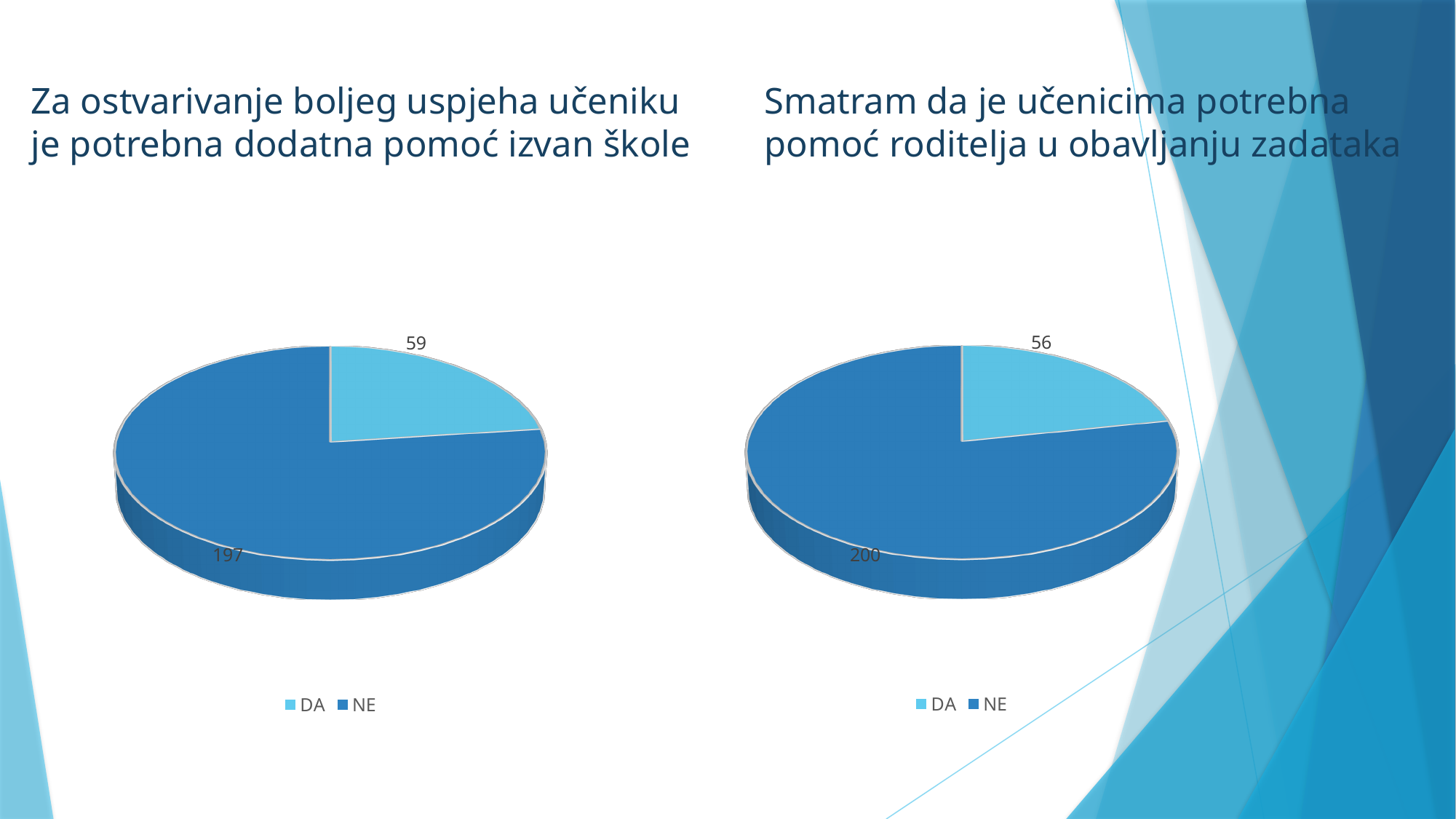
In the left chart, what is the difference between the NE and DA values? 138 What kind of chart is the left chart? Pie chart How many slices does the right chart have? 2 In the right chart, what is the difference between the NE and DA values? 144 What entries does the legend of the left chart list? DA, NE In the right chart, which category has the smallest slice? DA In the left chart, which category has the largest slice? NE In the left chart (Za ostvarivanje boljeg uspjeha učeniku je potrebna dodatna pomoć izvan škole), what is the value for NE? 197 Which is larger: the DA value in the left chart or the DA value in the right chart? The DA value in the left chart In the right chart (Smatram da je učenicima potrebna pomoć roditelja u obavljanju zadataka), what is the value for NE? 200 In the right chart (Smatram da je učenicima potrebna pomoć roditelja u obavljanju zadataka), what is the value for DA? 56 In the left chart (Za ostvarivanje boljeg uspjeha učeniku je potrebna dodatna pomoć izvan škole), what is the value for DA? 59